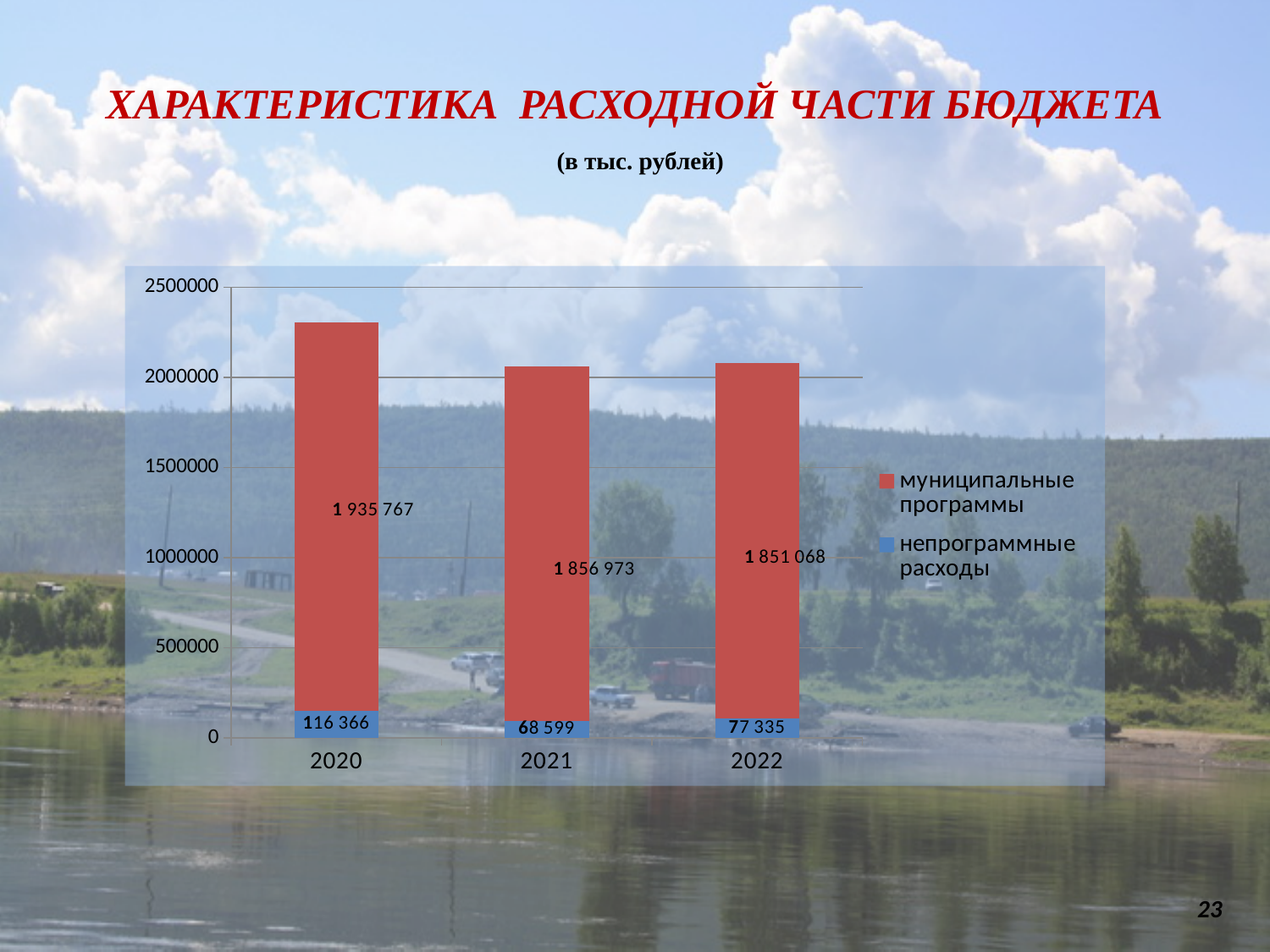
Does the value for муниципальные программы rise or fall from 2020 to 2022? Fall What is the value for муниципальные программы in 2020? 1 935 767 What is the difference between муниципальные программы in 2020 and in 2021? 78 794 Which colour represents непрограммные расходы in the legend? Blue How many series does the legend list? 2 What is the value for непрограммные расходы in 2021? 68 599 What kind of chart is shown on the slide? Stacked bar chart In which year is the value for непрограммные расходы the lowest? 2021 Which is larger: непрограммные расходы in 2020 or in 2022? 2020 In which year is the value for муниципальные программы the highest? 2020 How many years are shown on the x axis? 3 What is the value for непрограммные расходы in 2022? 77 335